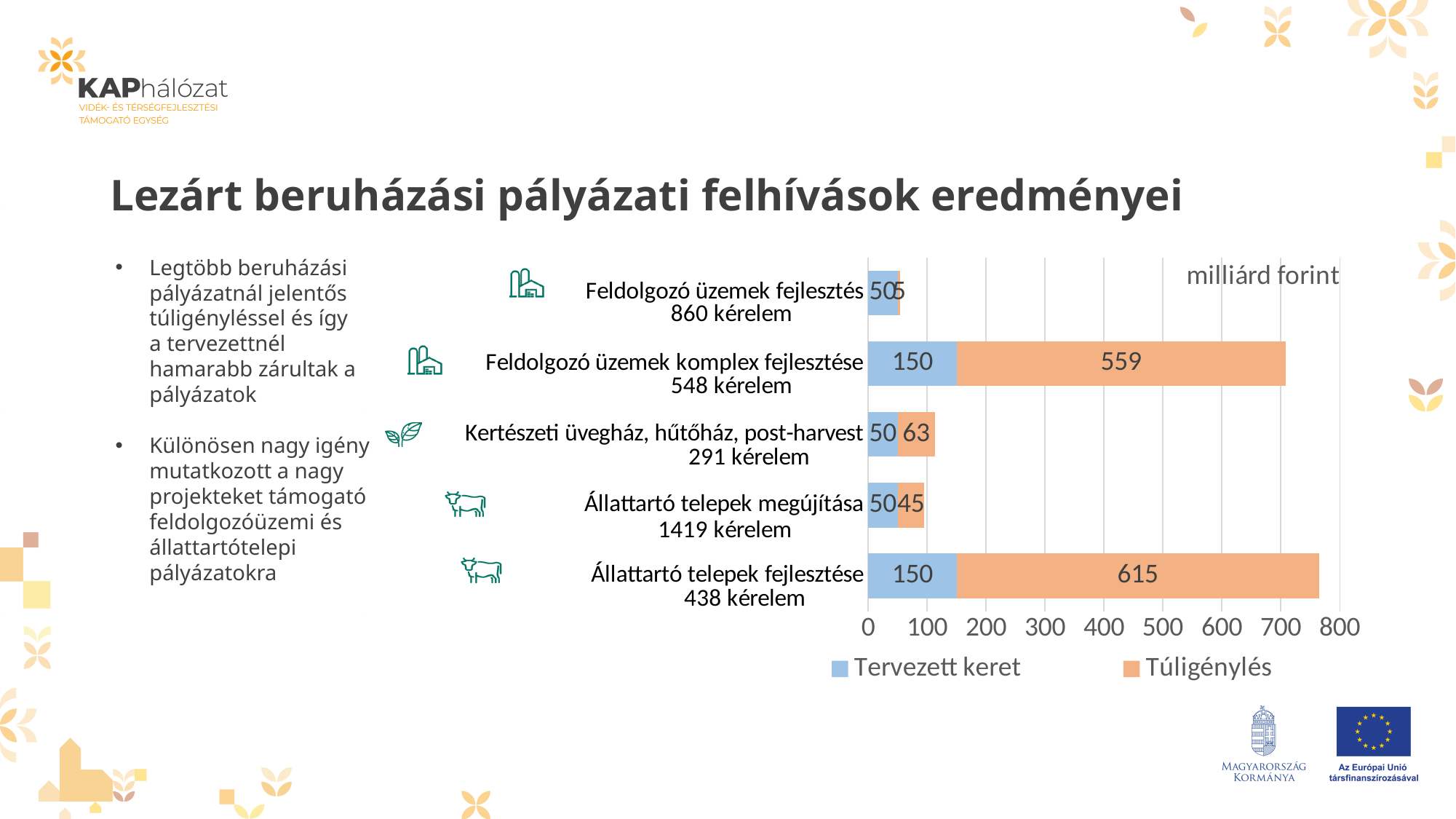
How many categories are plotted in the chart? 5 What is the Túligénylés value for Kertészeti üvegház, hűtőház, post-harvest? 63 What kind of chart is shown on the slide? bar chart What is the total of the stacked bar for Feldolgozó üzemek komplex fejlesztése? 709 What is the Túligénylés value for Állattartó telepek fejlesztése? 615 What is the total of the stacked bar for Állattartó telepek fejlesztése? 765 What is the Tervezett keret value for Feldolgozó üzemek komplex fejlesztése? 150 How many series does the legend list? 2 What is the difference between the Túligénylés values for Állattartó telepek fejlesztése and Feldolgozó üzemek komplex fejlesztése? 56 Which has the larger Túligénylés value: Kertészeti üvegház, hűtőház, post-harvest or Állattartó telepek megújítása? Kertészeti üvegház, hűtőház, post-harvest Which category has the highest Túligénylés value? Állattartó telepek fejlesztése What unit is shown in the top right corner of the chart? milliárd forint